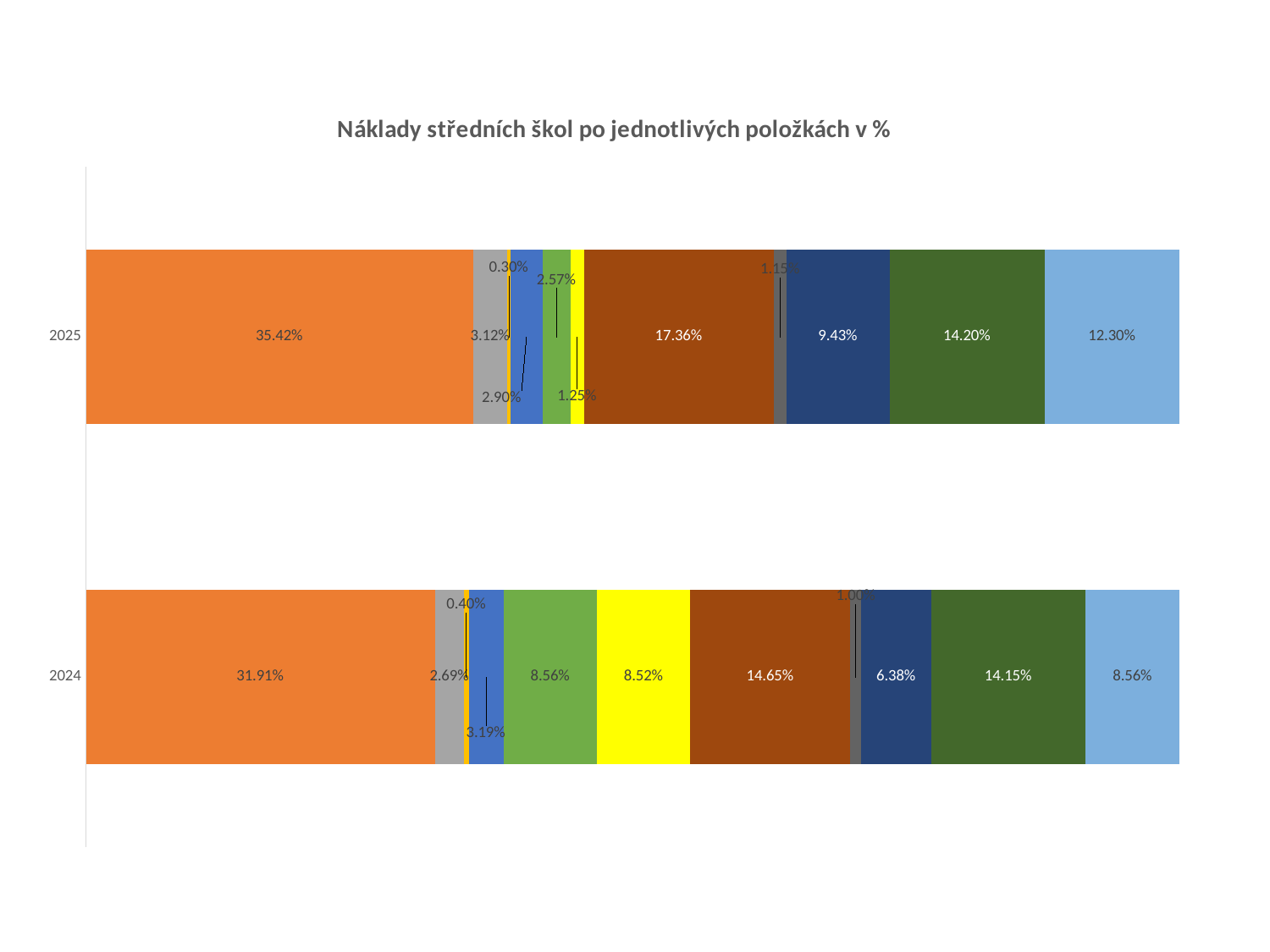
What is the title of the chart? Náklady středních škol po jednotlivých položkách v % What is the value of the orange (first) segment for 2024? 31.91% What is the value of the orange (first) segment for 2025? 35.42% How many years (bars) are shown in the chart? 2 What is the value of the dark green segment for 2024? 14.15% Is the dark blue segment larger in 2025 or in 2024? 2025 Which segment is the largest in the 2025 bar, and what is its value? The orange segment, 35.42% What is the value of the light blue (last) segment for 2024? 8.56% What kind of chart is shown on the slide? Stacked bar chart What is the value of the brown segment for 2025? 17.36% By how many percentage points does the orange segment differ between 2025 (35.42%) and 2024 (31.91%)? 3.51 percentage points What is the smallest labelled segment value in the 2025 bar? 0.30%